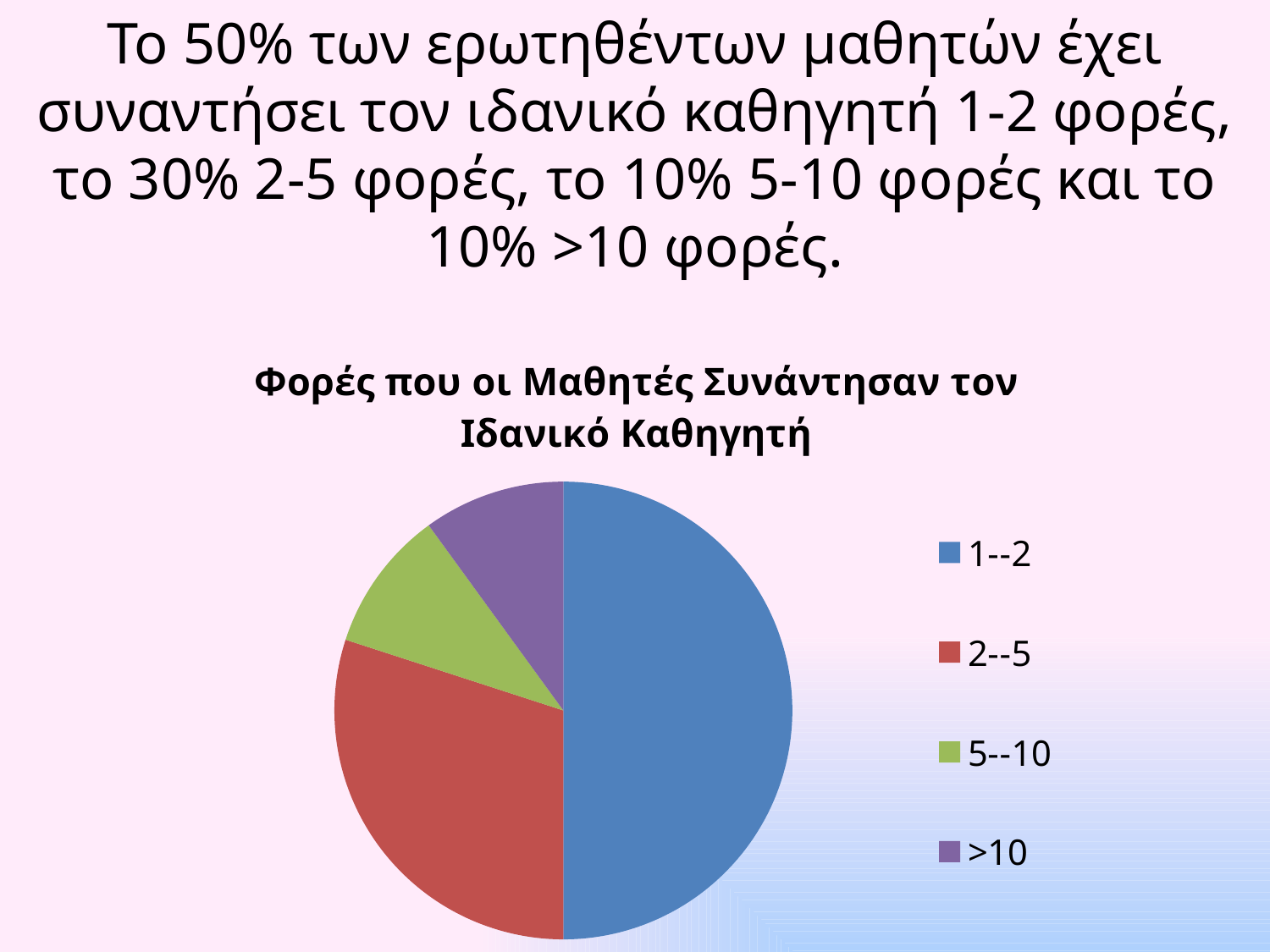
According to the slide, what share of the pie does the 2--5 category represent? 30% How many entries does the legend of the pie chart list? 4 What is the title of the pie chart? Φορές που οι Μαθητές Συνάντησαν τον Ιδανικό Καθηγητή How many slices does the pie chart have? 4 Which category has the largest slice of the pie chart? 1--2 Which slice is larger, 2--5 or 5--10? 2--5 Which slice is larger, 2--5 or >10? 2--5 What colour is the slice for the 2--5 category? red What kind of chart is shown on the slide? pie chart Which slice is larger, 1--2 or 2--5? 1--2 According to the slide, what share of the pie does the >10 category represent? 10% According to the slide, what share of the pie does the 1--2 category represent? 50%